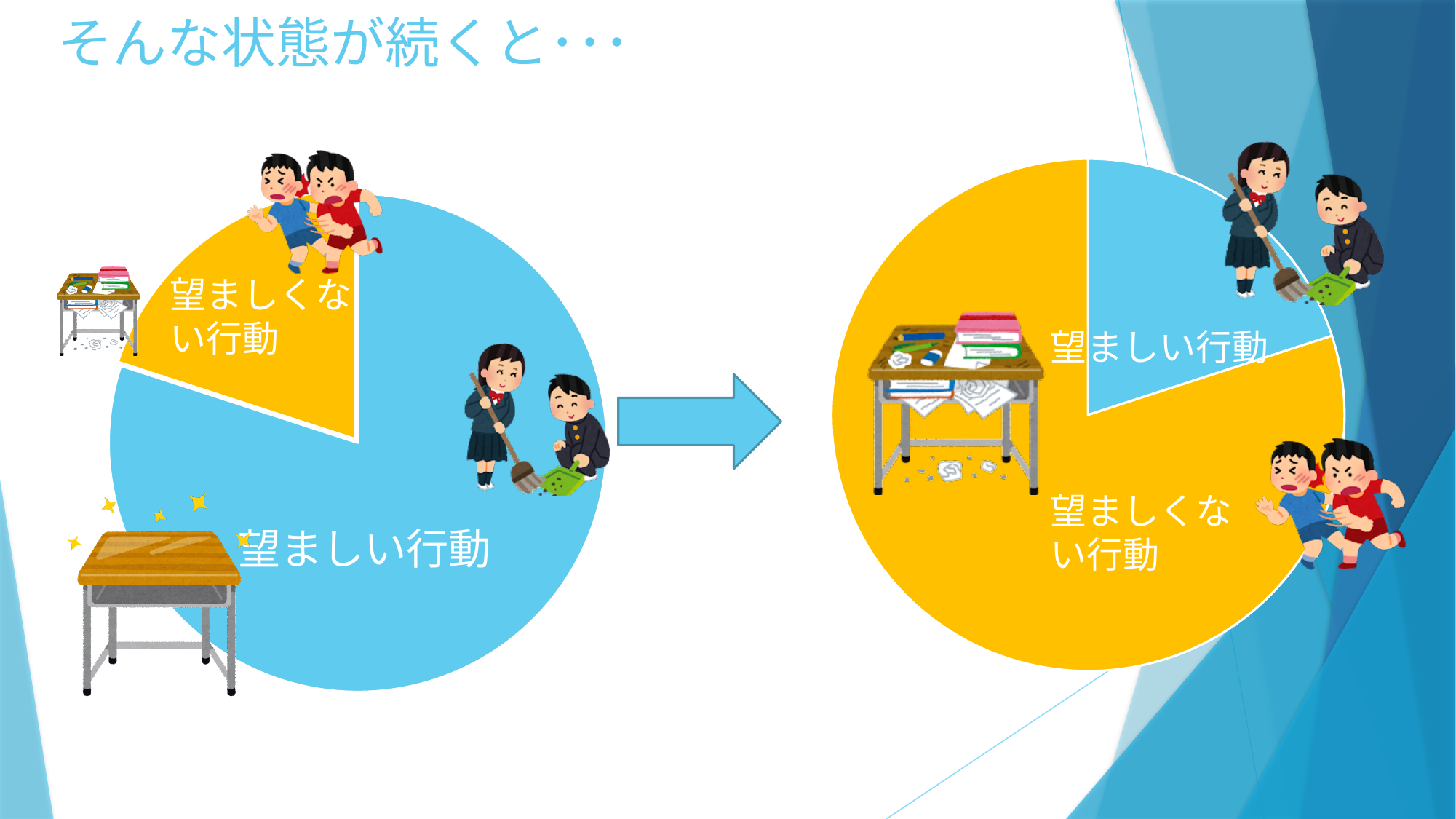
What kind of chart is the right chart on the slide? pie chart What is the title of the slide? そんな状態が続くと・・・ How many slices does the left pie chart have? 2 In the left pie chart, which slice is the largest? 望ましい行動 What colour is the 望ましい行動 slice in the left pie chart? blue In the right pie chart, which slice is the largest? 望ましくない行動 In the right pie chart, which slice is the smallest? 望ましい行動 In the left pie chart, which slice is the smallest? 望ましくない行動 In the left pie chart, which is larger: 望ましい行動 or 望ましくない行動? 望ましい行動 In the right pie chart, which is larger: 望ましい行動 or 望ましくない行動? 望ましくない行動 How many slices does the right pie chart have? 2 What kind of chart is the left chart on the slide? pie chart